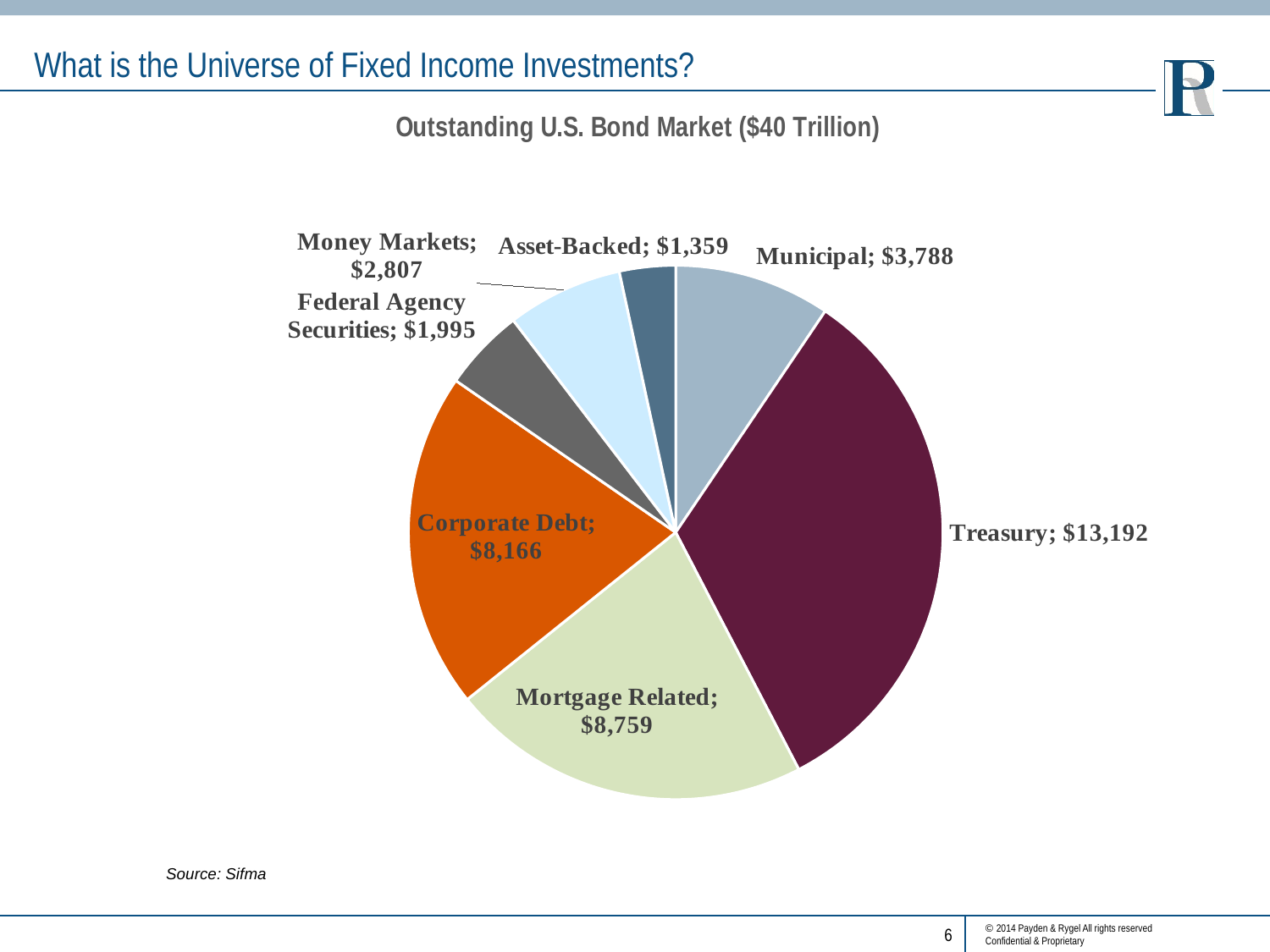
Which is larger, Mortgage Related or Corporate Debt? Mortgage Related What is the difference between the Treasury value and the Mortgage Related value? $4,433 How many slices does the pie chart have? 7 What is the value shown for Money Markets? $2,807 What is the value shown for Treasury? $13,192 What is the title of the chart? Outstanding U.S. Bond Market ($40 Trillion) What is the value shown for Federal Agency Securities? $1,995 What is the value shown for Mortgage Related? $8,759 What type of chart is shown on the slide? Pie chart Which category has the largest slice of the pie? Treasury Which category has the smallest slice of the pie? Asset-Backed What is the difference between the Municipal value and the Asset-Backed value? $2,429